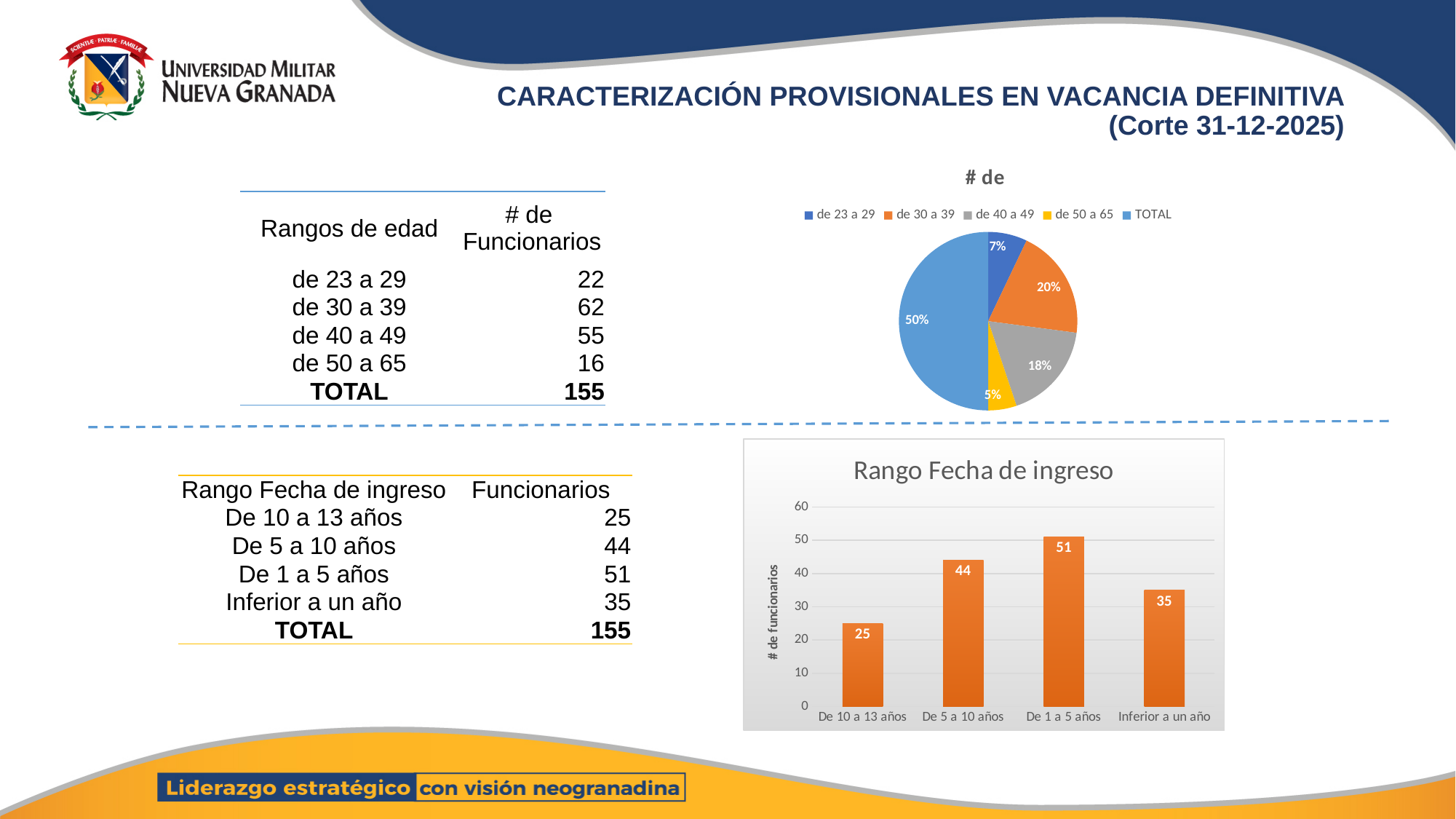
In the pie chart titled "# de", what percentage is shown for the "de 50 a 65" slice? 5% What kind of chart is the chart titled "Rango Fecha de ingreso"? bar chart In the bar chart titled "Rango Fecha de ingreso", how many categories are shown on the x axis? 4 In the bar chart titled "Rango Fecha de ingreso", what is the value for "Inferior a un año"? 35 In the bar chart titled "Rango Fecha de ingreso", which category has the highest value? De 1 a 5 años In the pie chart titled "# de", what percentage is shown for the "de 30 a 39" slice? 20% In the pie chart titled "# de", how many entries does the legend list? 5 In the pie chart titled "# de", which slice is the largest? TOTAL In the bar chart titled "Rango Fecha de ingreso", which is larger: the value for "De 5 a 10 años" or the value for "Inferior a un año"? De 5 a 10 años In the bar chart titled "Rango Fecha de ingreso", which category has the lowest value? De 10 a 13 años In the bar chart titled "Rango Fecha de ingreso", what is the difference between the values for "De 1 a 5 años" and "De 10 a 13 años"? 26 In the bar chart titled "Rango Fecha de ingreso", what is the value for "De 1 a 5 años"? 51